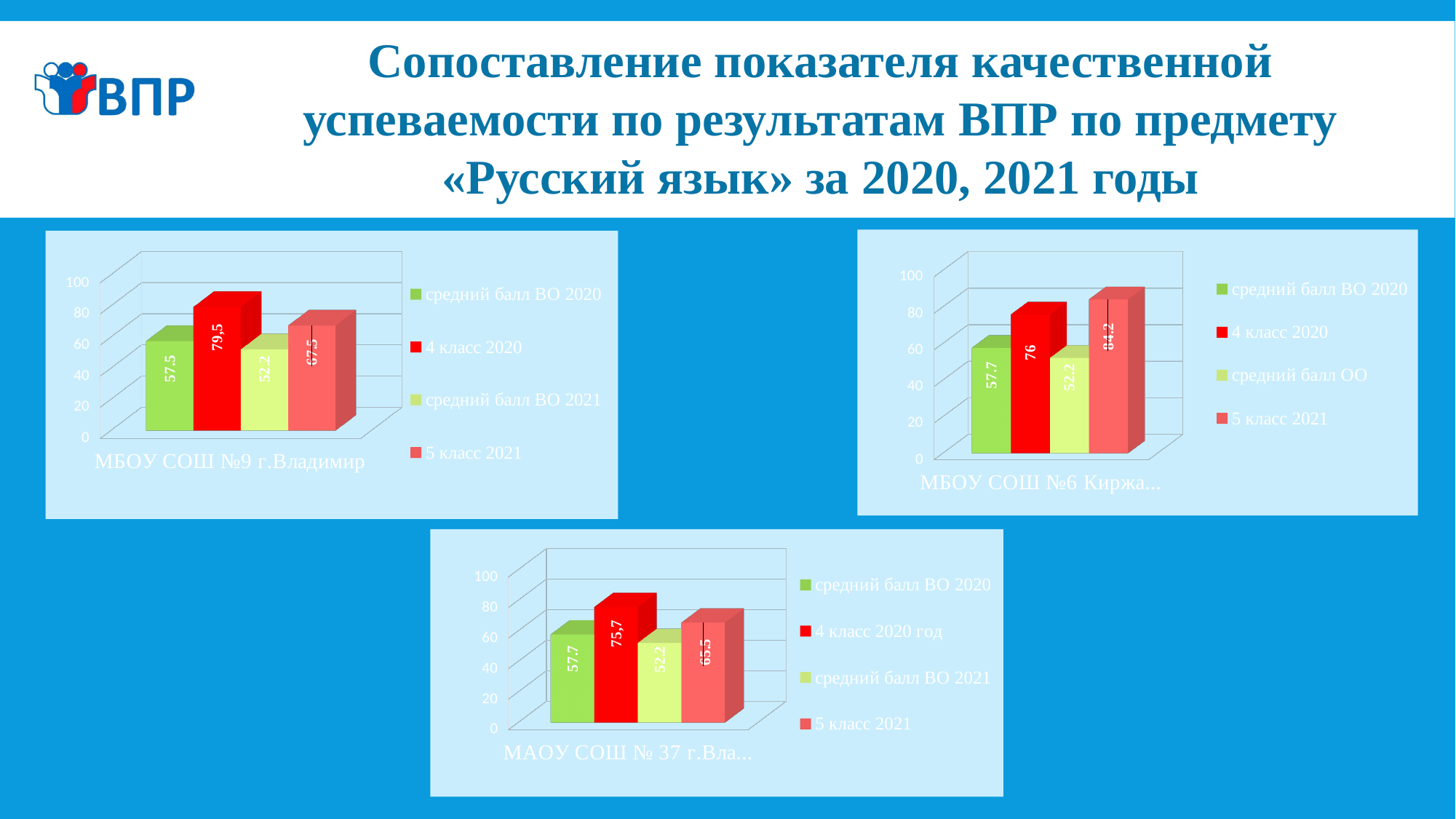
How many series does the legend of the top-right chart (МБОУ СОШ №6 Киржа...) list? 4 What kind of chart is the bottom chart (МАОУ СОШ № 37 г.Вла...)? Bar chart In the top-right chart (МБОУ СОШ №6 Киржа...), what colour is the bar for the series "4 класс 2020"? Red In the top-left chart (МБОУ СОШ №9 г.Владимир), what is the value for the series "4 класс 2020"? 79,5 In the bottom chart (МАОУ СОШ № 37 г.Вла...), which series has the lowest value? средний балл ВО 2021 In the top-right chart (МБОУ СОШ №6 Киржа...), what is the value for the series "5 класс 2021"? 84.2 In the top-left chart (МБОУ СОШ №9 г.Владимир), which is larger: the value for "4 класс 2020" or the value for "5 класс 2021"? 4 класс 2020 In the bottom chart (МАОУ СОШ № 37 г.Вла...), what is the difference between the values for "4 класс 2020 год" and "5 класс 2021"? 10.2 In the top-left chart (МБОУ СОШ №9 г.Владимир), what is the value for the series "5 класс 2021"? 67.5 In the top-right chart (МБОУ СОШ №6 Киржа...), what is the value for the series "4 класс 2020"? 76 In the bottom chart (МАОУ СОШ № 37 г.Вла...), what is the value for the series "4 класс 2020 год"? 75,7 In the top-right chart (МБОУ СОШ №6 Киржа...), which series has the highest value? 5 класс 2021